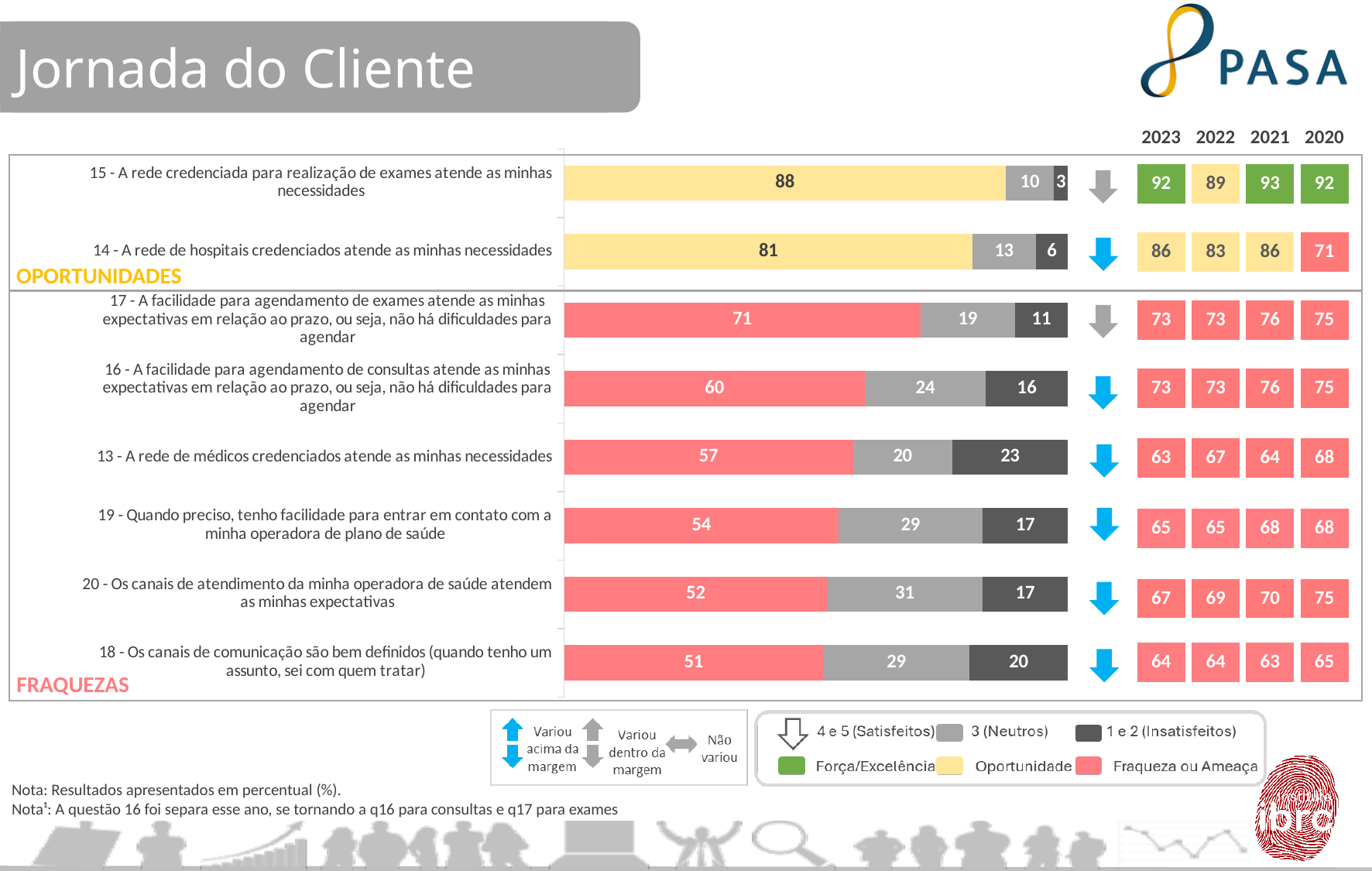
How many items (questions) are plotted in the bar chart? 8 Which has a larger dissatisfied (1 e 2) percentage: item 16 or item 13? Item 13 Which item has the highest satisfied (4 e 5) percentage? 15 - A rede credenciada para realização de exames atende as minhas necessidades What is the difference between the satisfied percentages of item 15 (88) and item 14 (81)? 7 How many response categories does the legend list for the bar segments? 3 What percentage of respondents were satisfied (4 e 5) for item 15 - A rede credenciada para realização de exames atende as minhas necessidades? 88 What is the dissatisfied (1 e 2) percentage for item 13 - A rede de médicos credenciados atende as minhas necessidades? 23 What type of chart is used to show the satisfaction results? Stacked bar chart Which item has the lowest satisfied (4 e 5) percentage? 18 - Os canais de comunicação são bem definidos What was the 2020 value for item 14 - A rede de hospitais credenciados atende as minhas necessidades? 71 What is the neutral (3) percentage for item 20 - Os canais de atendimento da minha operadora de saúde atendem as minhas expectativas? 31 What is the total of the three segments for item 16 - A facilidade para agendamento de consultas? 100